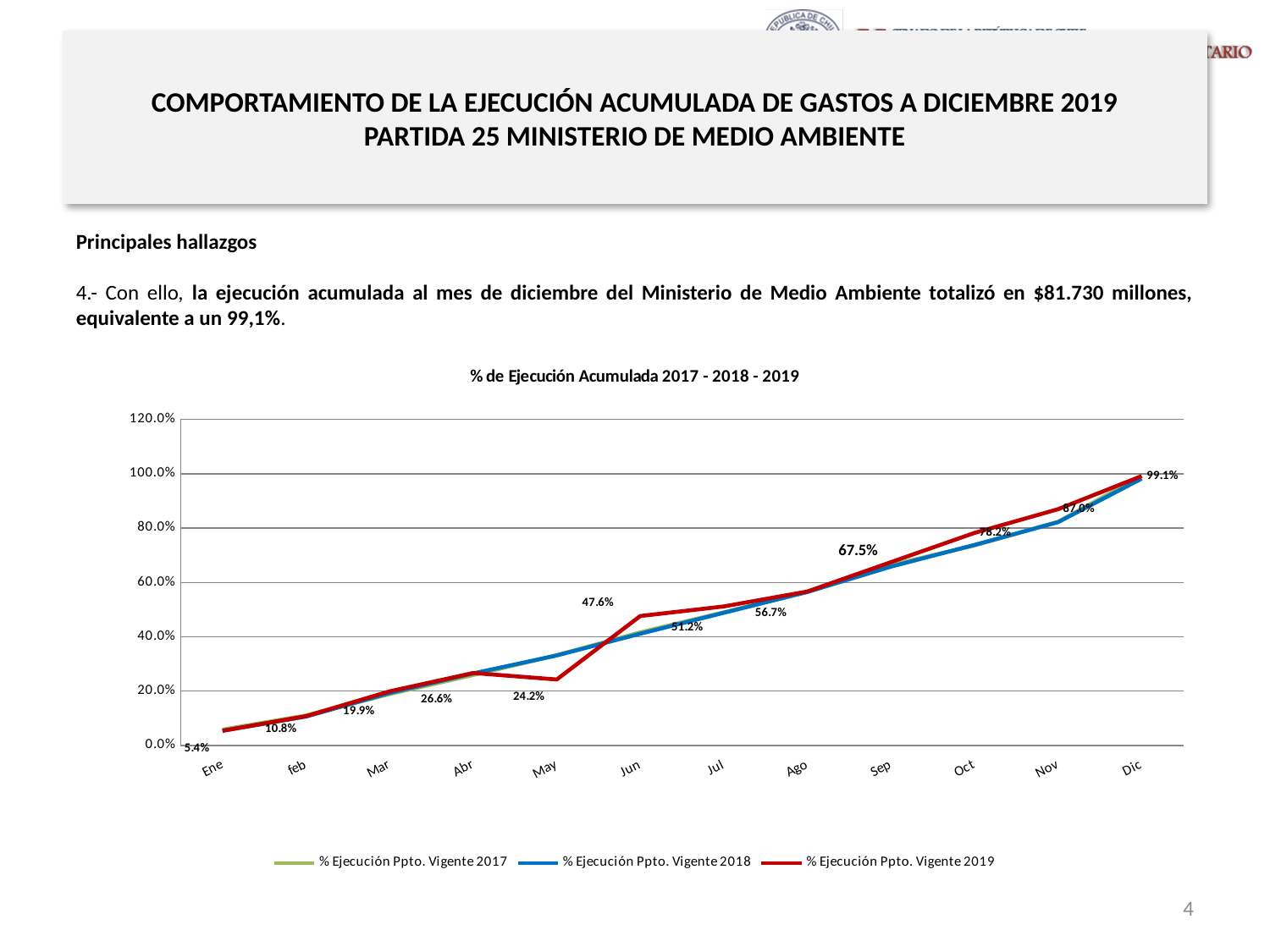
What is the difference between the labelled 2019 values for Jun and May? 23.4% How many months are shown on the x axis of the chart? 12 In which month is the labelled value for % Ejecución Ppto. Vigente 2019 lowest? Ene What type of chart is shown on the slide? line chart What is the labelled value for % Ejecución Ppto. Vigente 2019 in May? 24.2% Does the % Ejecución Ppto. Vigente 2018 line generally rise or fall from Ene to Dic? rise Is the value for % Ejecución Ppto. Vigente 2018 in Oct greater or less than 80%? less For % Ejecución Ppto. Vigente 2019, which month has the larger labelled value, Abr or May? Abr How many series does the chart legend list? 3 What is the labelled value for % Ejecución Ppto. Vigente 2019 in Sep? 67.5% What is the labelled value for % Ejecución Ppto. Vigente 2019 in Dic? 99.1% What is the title of the chart? % de Ejecución Acumulada 2017 - 2018 - 2019